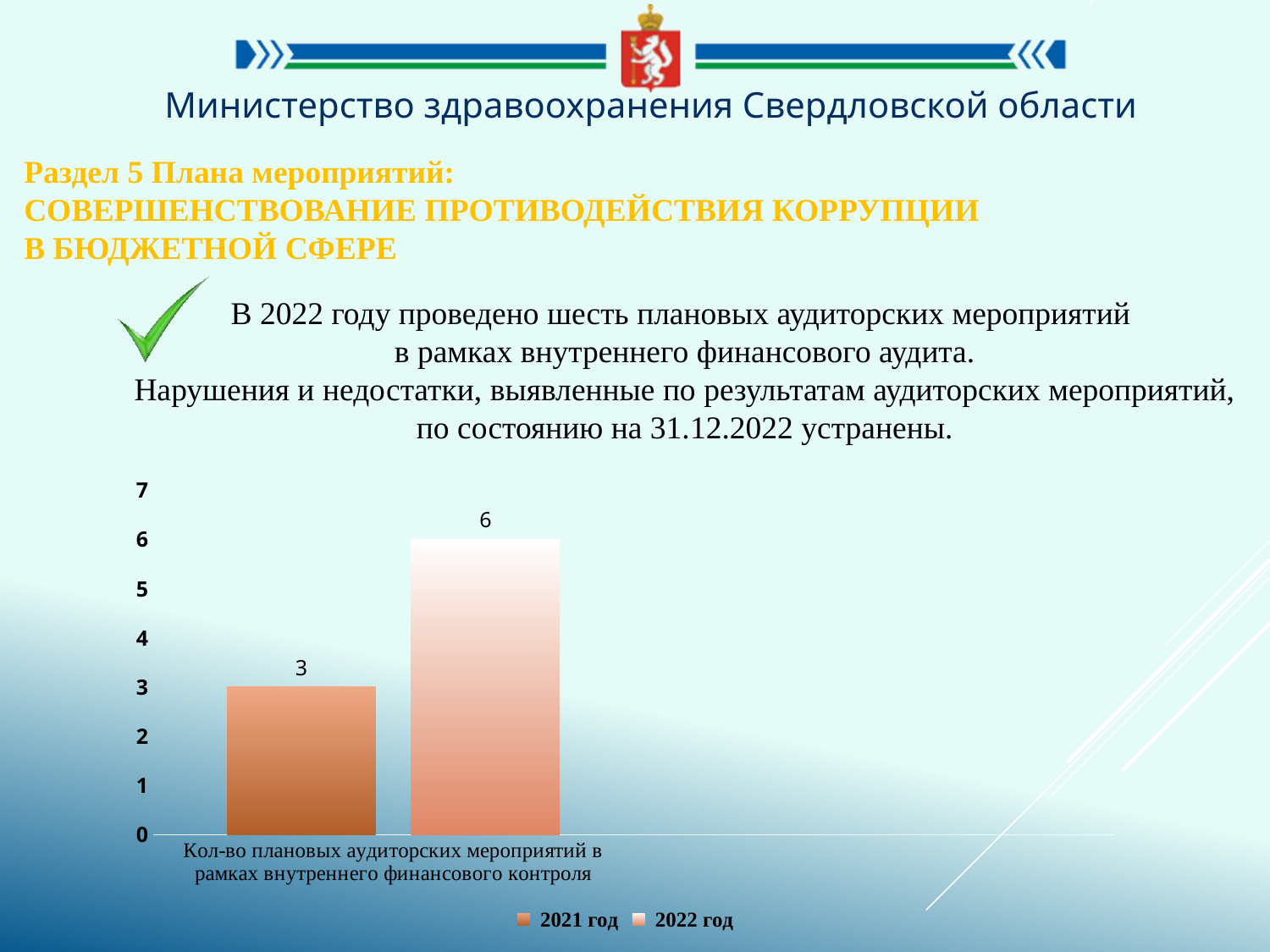
Is the value for 2022 год greater or less than 5? greater Which year has the lower value in the chart? 2021 год Which year has the higher value in the chart? 2022 год What kind of chart is shown on the slide? bar chart What is the highest value shown on the vertical axis? 7 What is the value for 2021 год in the chart? 3 What is the category label shown under the bars? Кол-во плановых аудиторских мероприятий в рамках внутреннего финансового контроля What is the difference between the 2022 год and 2021 год values? 3 What is the value for 2022 год in the chart? 6 Did the number of planned audit activities rise or fall from 2021 год to 2022 год? rise Is the value for 2021 год larger or smaller than the value for 2022 год? smaller How many series does the legend list? 2